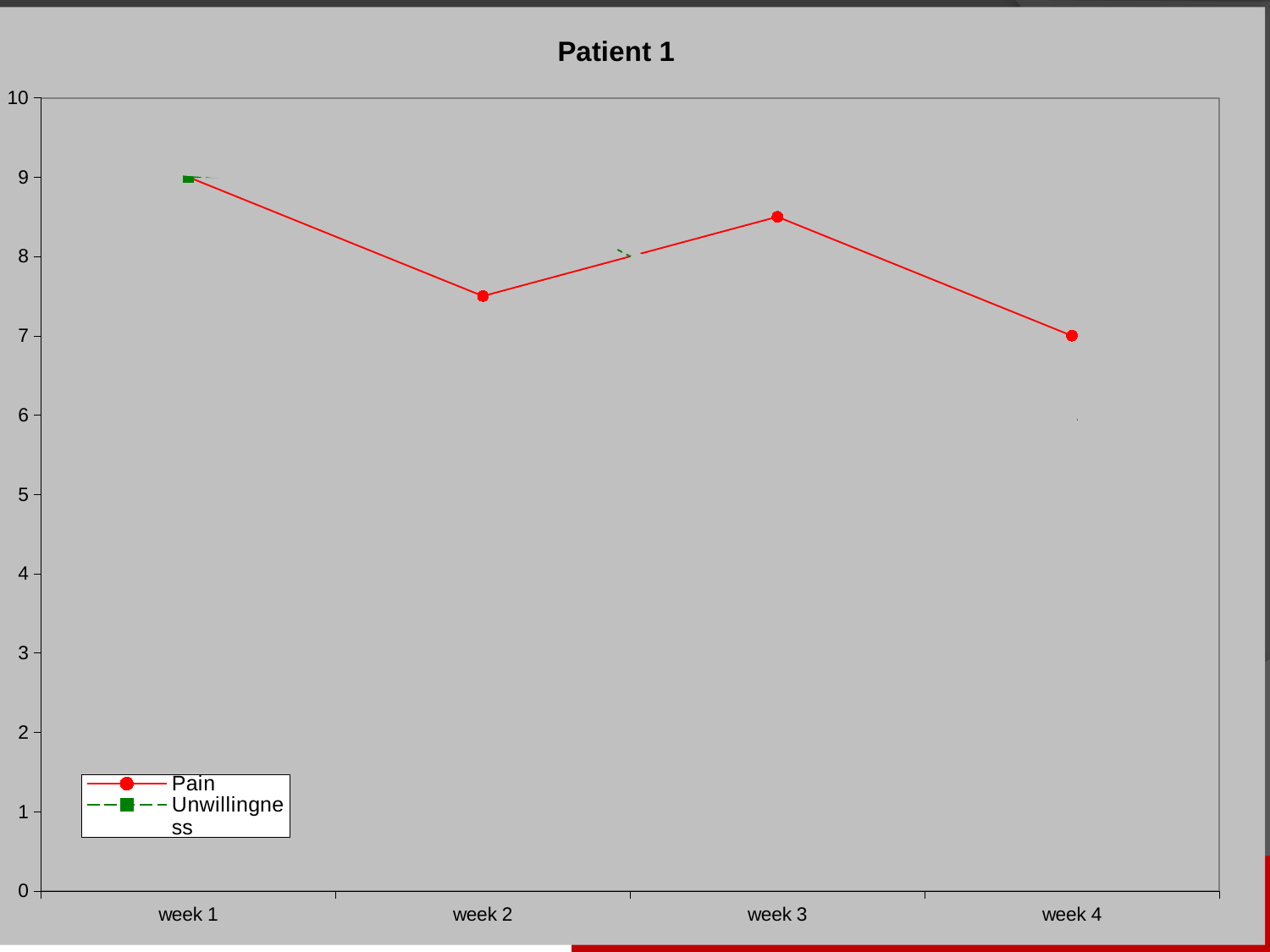
Which has the larger Pain value, week 2 or week 3? week 3 What is the Pain value at week 1? 9 Is the Pain value at week 2 greater or less than 8? less What is the title of the chart? Patient 1 What is the Pain value at week 4? 7 What type of chart is shown on the slide? Line chart In which week is the Pain value highest? week 1 In which week is the Pain value lowest? week 4 How many weeks are shown on the x axis? 4 How many series does the legend list? 2 What is the difference between the Pain value at week 1 and at week 4? 2 Is the Pain value at week 3 greater or less than 8? greater